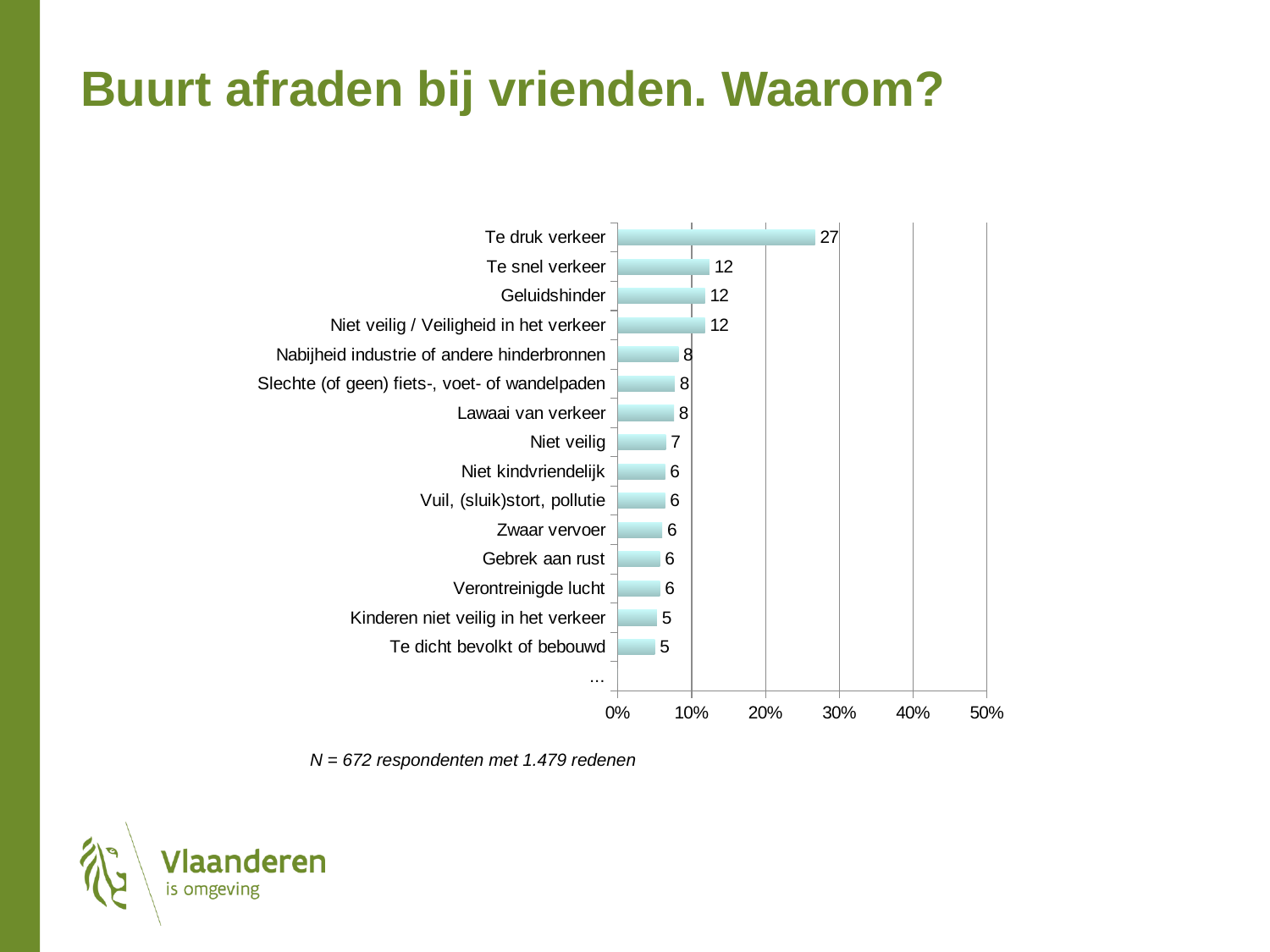
What is the difference between the values for 'Geluidshinder' and 'Niet kindvriendelijk'? 6 What is the value for 'Niet veilig'? 7 What is the value for 'Lawaai van verkeer'? 8 What is the value for 'Te druk verkeer'? 27 Which category has the highest value? Te druk verkeer What type of chart is shown on the slide? bar chart How many bars are plotted in the chart? 15 Is the value for 'Te druk verkeer' greater or less than 20%? greater Which is larger, the value for 'Nabijheid industrie of andere hinderbronnen' or the value for 'Zwaar vervoer'? Nabijheid industrie of andere hinderbronnen What is the difference between the values for 'Te druk verkeer' and 'Te snel verkeer'? 15 What is the title of the slide? Buurt afraden bij vrienden. Waarom? What is the value for 'Te dicht bevolkt of bebouwd'? 5